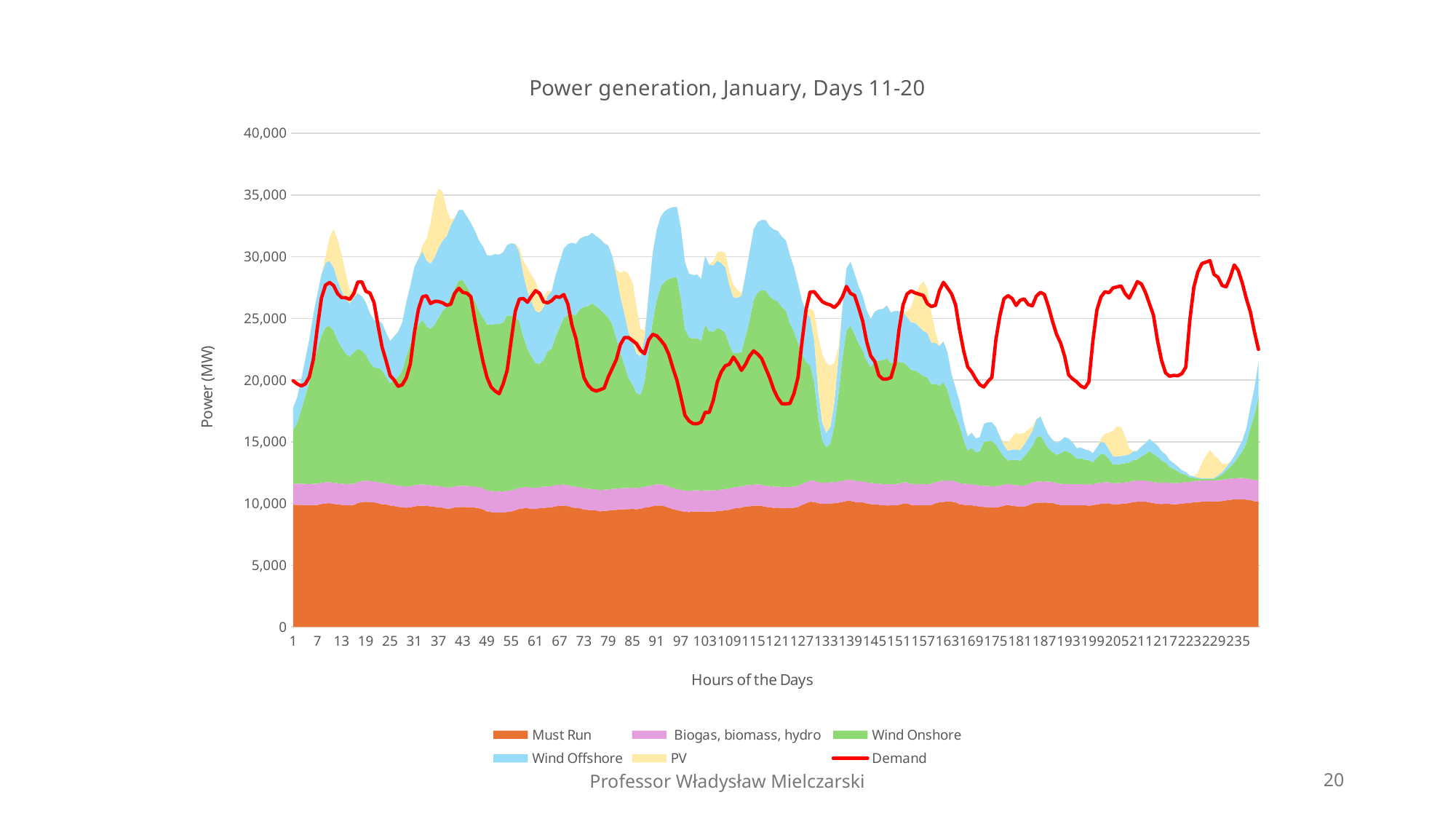
What type of chart is shown on the slide? area chart Is the value for Demand at hour 133 greater or less than 20,000? greater How many series does the legend list? 6 Is the value for Demand at hour 1 greater or less than 25,000? less Is the value for Must Run at hour 1 greater or less than 15,000? less What is the title of the chart? Power generation, January, Days 11-20 Which series is drawn as a red line rather than a filled area? Demand